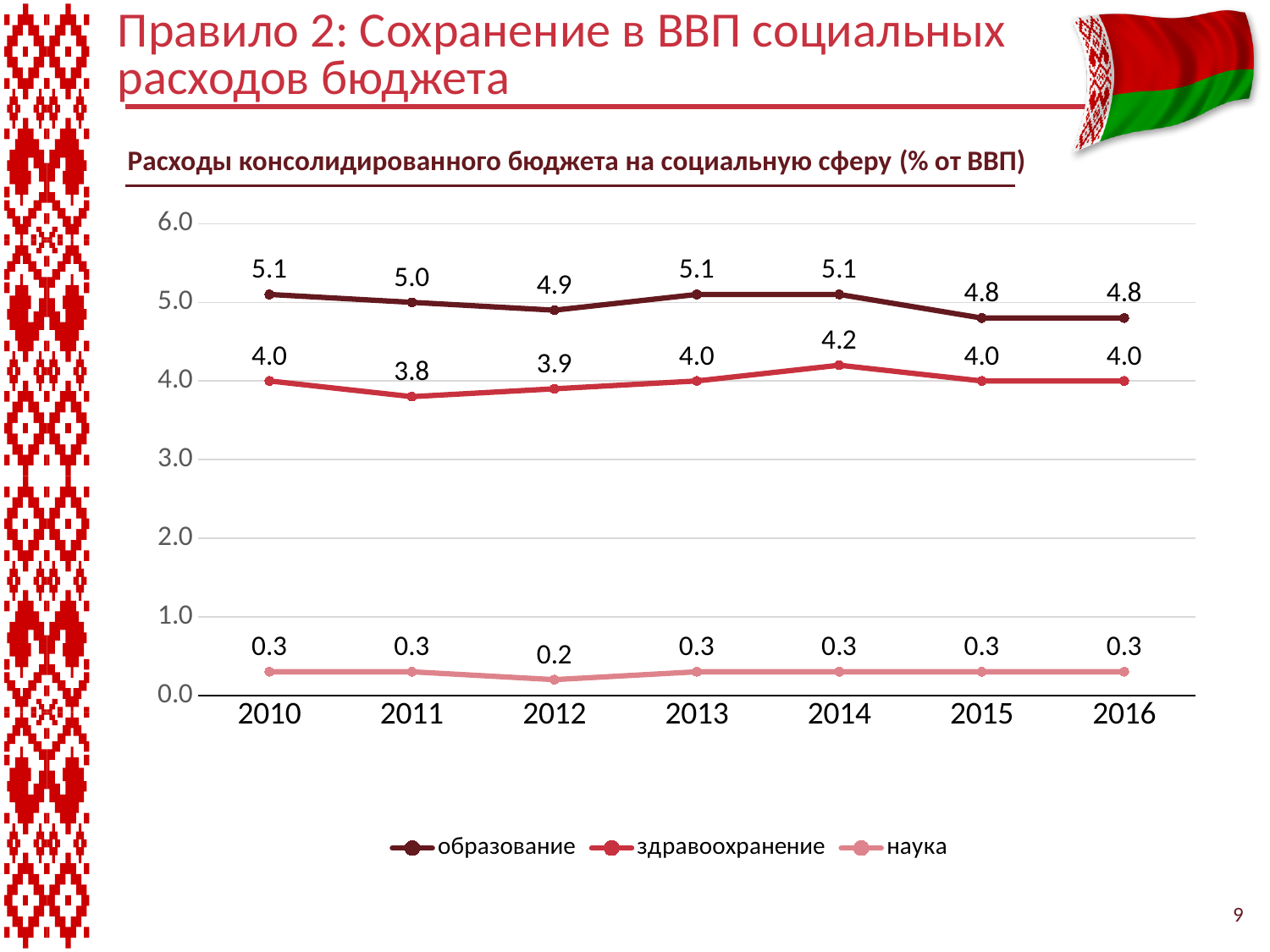
How many series does the legend list? 3 What is the value for здравоохранение in 2014? 4.2 What is the difference between образование and здравоохранение in 2010? 1.1 What is the value for образование in 2012? 4.9 What is the title of the chart? Расходы консолидированного бюджета на социальную сферу (% от ВВП) How many years are shown on the x axis? 7 Which is larger in 2016, образование or здравоохранение? образование Does образование rise or fall from 2014 to 2015? fall What is the value for наука in 2012? 0.2 What kind of chart is shown? line chart In which year is здравоохранение highest? 2014 In which year is здравоохранение lowest? 2011